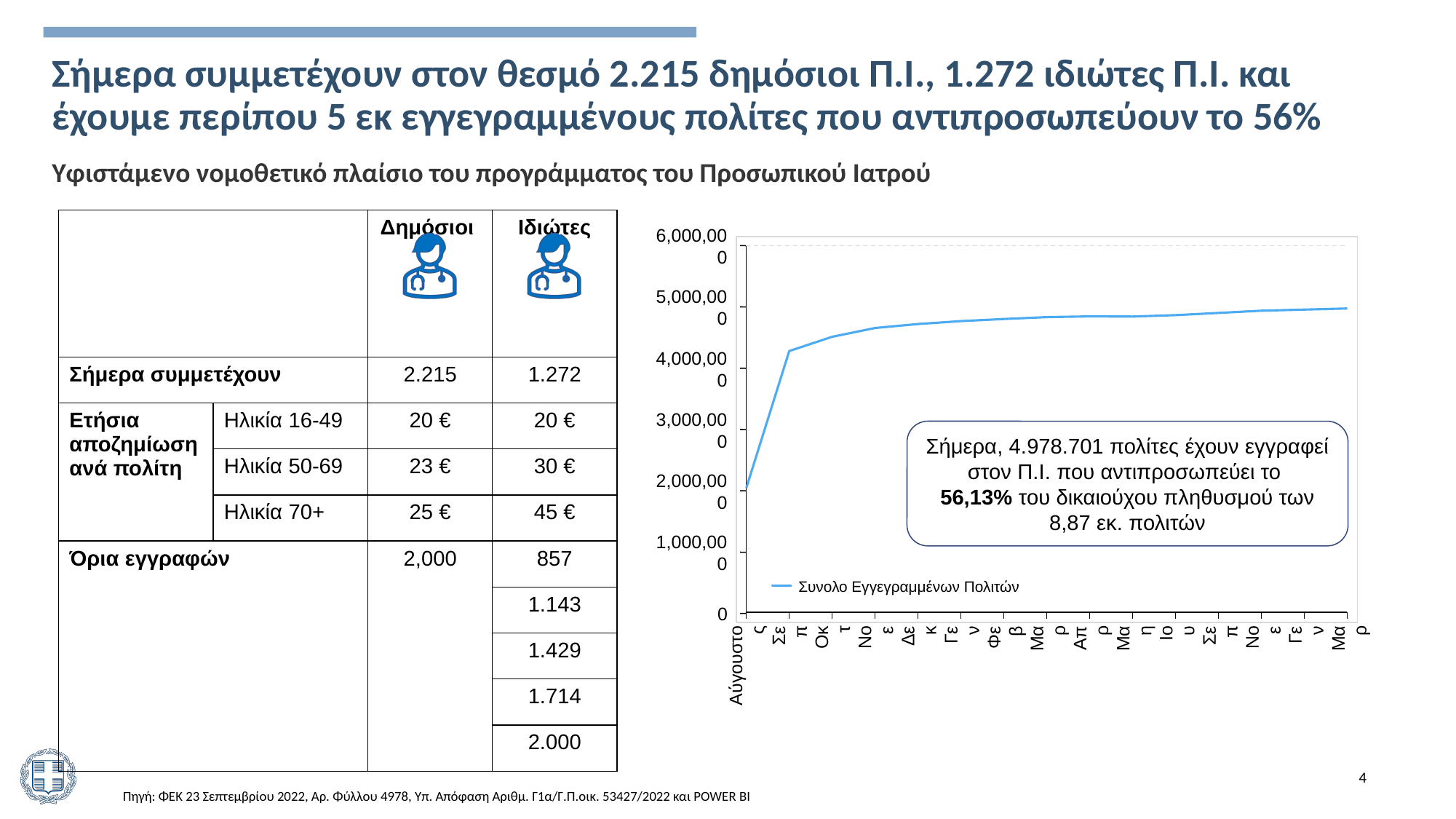
How many series does the legend of the line chart list? 1 According to the callout box on the line chart, what percentage of the eligible population has registered? 56,13% Do the values in the line chart generally rise or fall from left to right along the x axis? rise Is the value at the last point of the line chart greater or less than 4,000,000? greater What is the name of the series shown in the line chart's legend? Συνολο Εγγεγραμμένων Πολιτών Is the value at the last point of the line chart greater or less than 6,000,000? less Is the value for Αύγουστο (the first point) in the line chart greater or less than 3,000,000? less What kind of chart is shown on the right side of the slide? line chart In the line chart, is the value at the first point (Αύγουστο) larger or smaller than the value at the last point? smaller